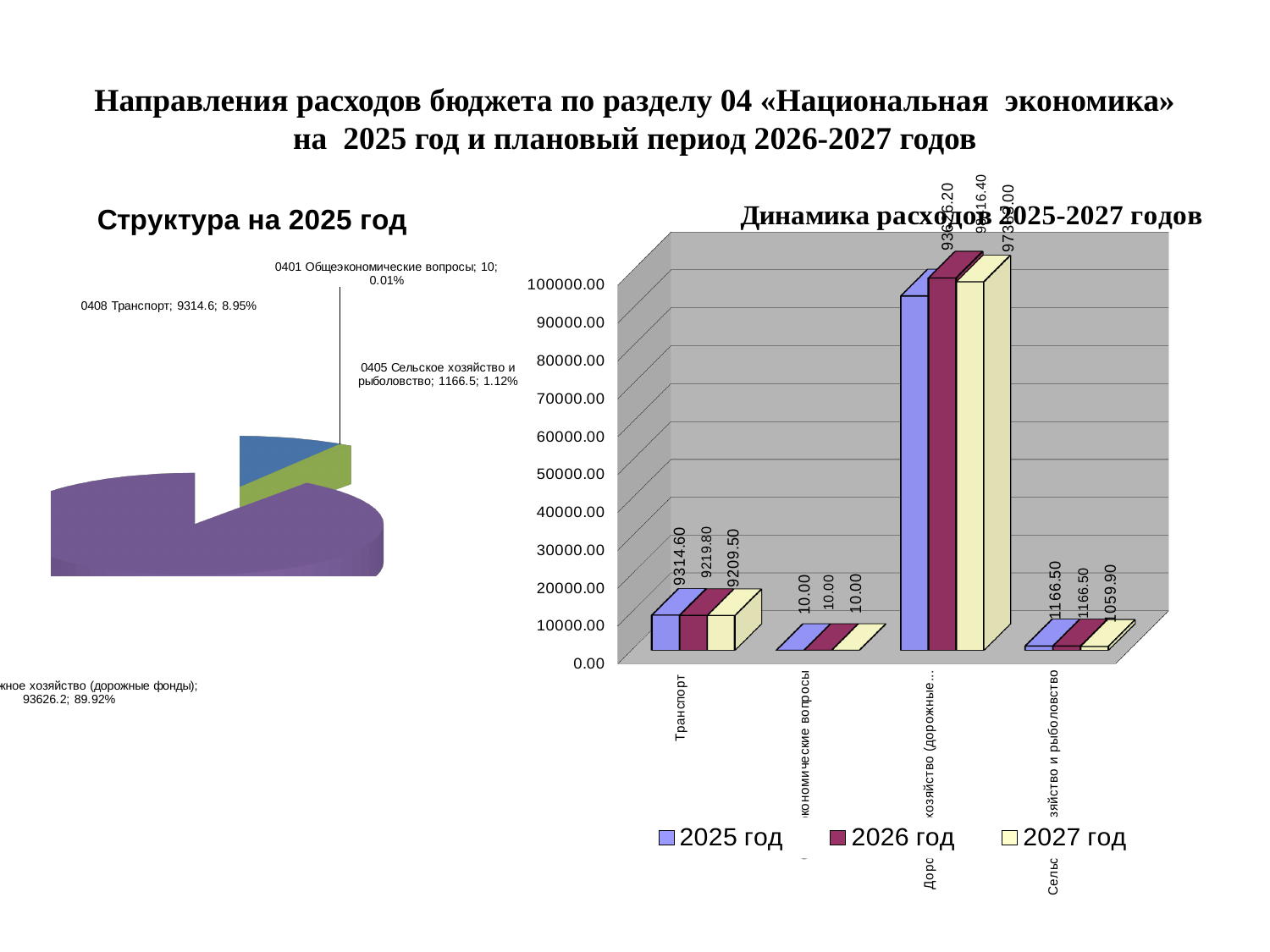
In the pie chart "Структура на 2025 год", what value is shown for 0405 Сельское хозяйство и рыболовство? 1166.5 In the chart "Динамика расходов 2025-2027 годов", what is the difference between the Транспорт values for 2025 год and 2026 год? 94.80 In the pie chart "Структура на 2025 год", what share does 0408 Транспорт have? 8.95% In the chart "Динамика расходов 2025-2027 годов", what is the value for Транспорт in 2027 год? 9209.50 What kind of chart is "Динамика расходов 2025-2027 годов"? bar chart In the chart "Динамика расходов 2025-2027 годов", do the values for Транспорт rise or fall from 2025 год to 2027 год? fall How many series does the legend of the chart "Динамика расходов 2025-2027 годов" list? 3 In the chart "Динамика расходов 2025-2027 годов", what is the value for Сельское хозяйство и рыболовство in 2027 год? 1059.90 How many slices does the pie chart "Структура на 2025 год" have? 4 In the pie chart "Структура на 2025 год", what share does 0401 Общеэкономические вопросы have? 0.01% In the chart "Динамика расходов 2025-2027 годов", what is the value for Транспорт in 2025 год? 9314.60 In the pie chart "Структура на 2025 год", what share does the largest slice have? 89.92%